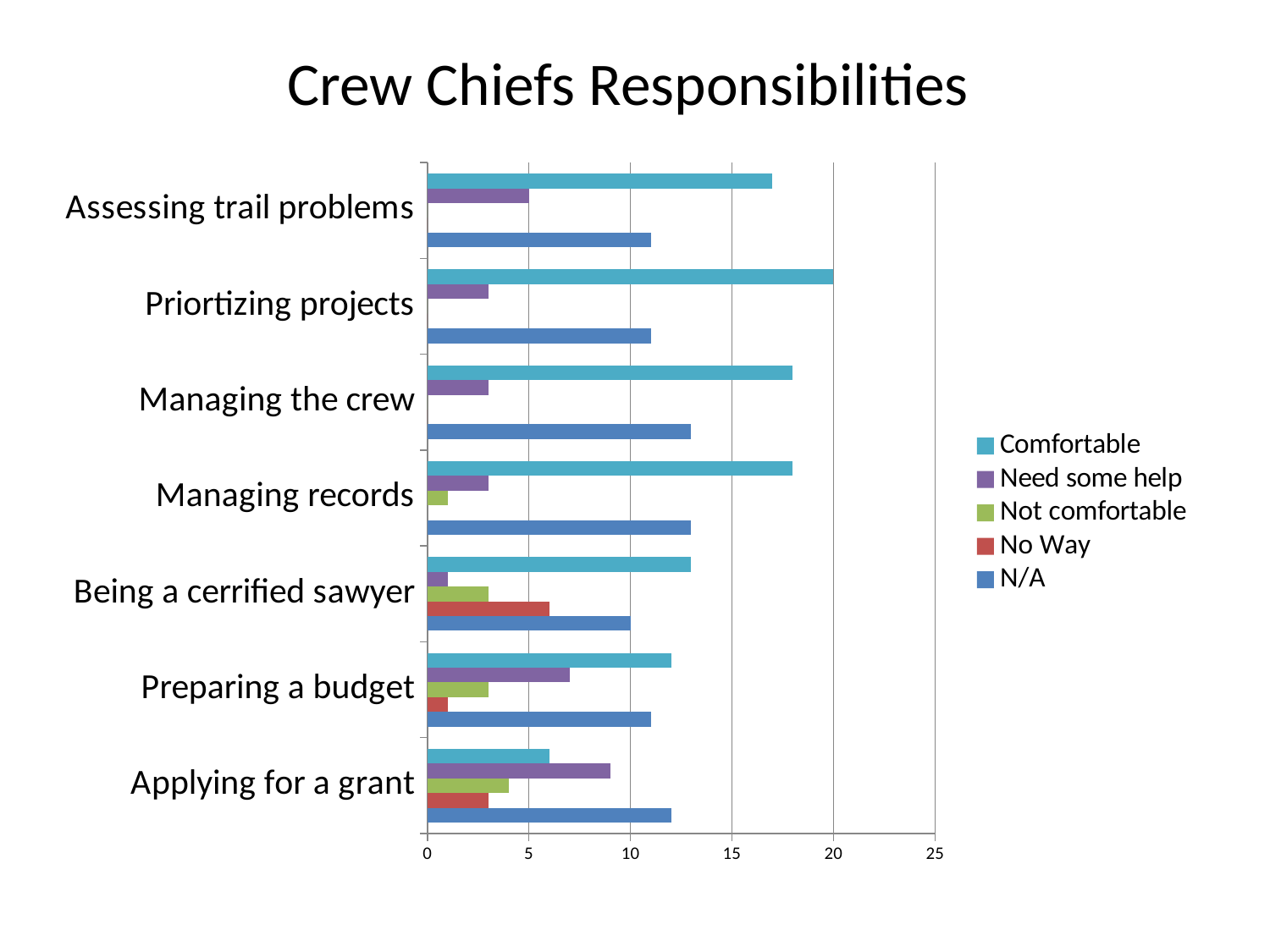
For Applying for a grant, which is larger: the Comfortable value or the Need some help value? Need some help What is the title of the chart? Crew Chiefs Responsibilities How many series does the legend list? 5 What is the N/A value for Being a cerrified sawyer? 10 What is the Need some help value for Assessing trail problems? 5 Is the Need some help value for Preparing a budget greater or less than 5? greater Is the Comfortable value for Managing the crew greater or less than 15? greater Which responsibility has the lowest Comfortable value? Applying for a grant What is the Comfortable value for Priortizing projects? 20 Which responsibility has the highest Comfortable value? Priortizing projects What type of chart is shown on the slide? bar chart How many responsibility categories are shown on the chart? 7